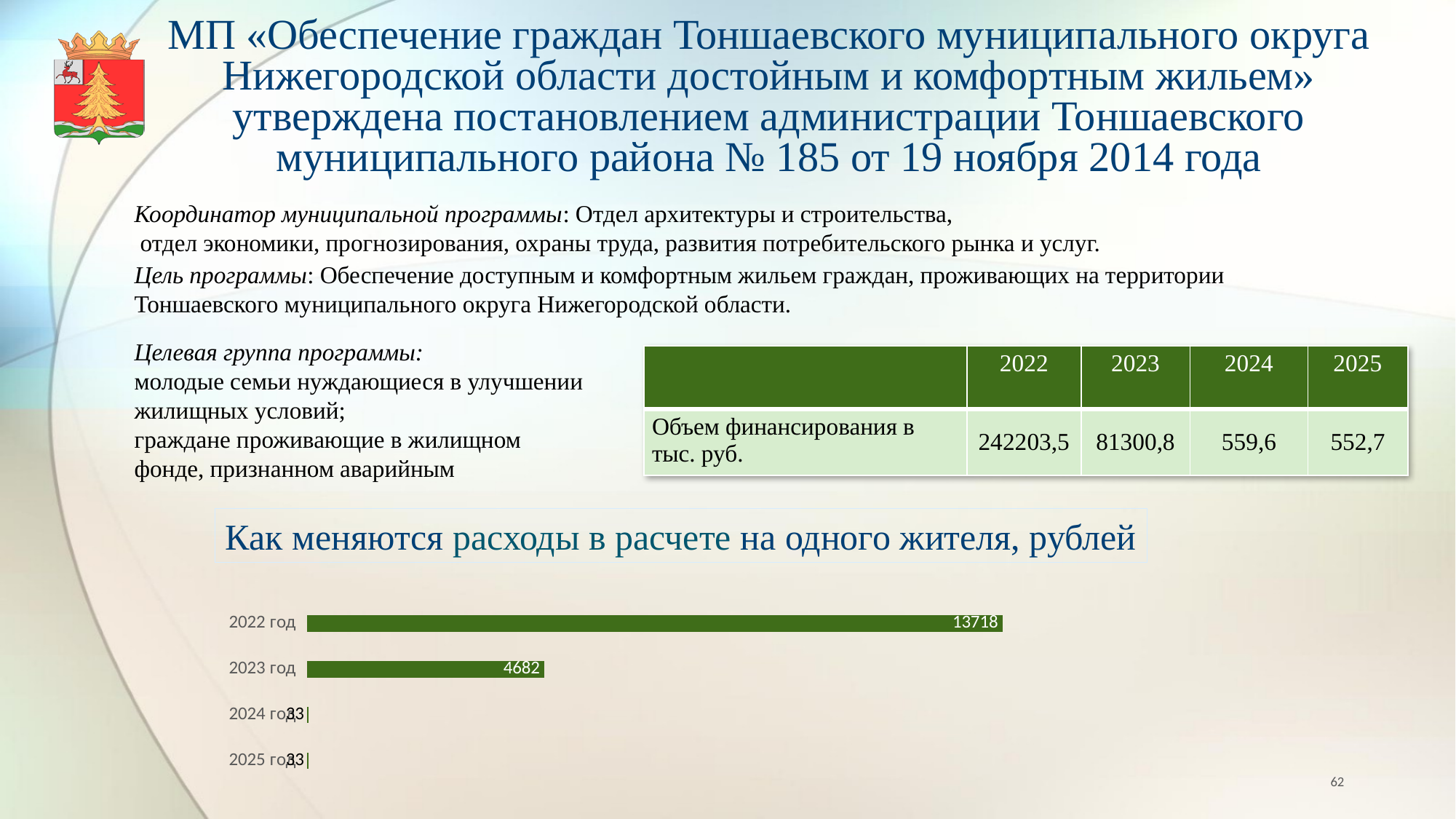
How many years (categories) are shown in the chart 'Как меняются расходы в расчете на одного жителя, рублей'? 4 What is the value for 2023 год in the chart 'Как меняются расходы в расчете на одного жителя, рублей'? 4682 In the chart 'Как меняются расходы в расчете на одного жителя, рублей', which is larger: the value for 2022 год or for 2023 год? 2022 год Which year has the highest value in the chart 'Как меняются расходы в расчете на одного жителя, рублей'? 2022 год What is the difference between the values for 2022 год and 2023 год in the chart 'Как меняются расходы в расчете на одного жителя, рублей'? 9036 What colour are the bars in the chart 'Как меняются расходы в расчете на одного жителя, рублей'? green Do the values in the chart 'Как меняются расходы в расчете на одного жителя, рублей' rise or fall from 2022 год to 2025 год? fall What is the value for 2022 год in the chart 'Как меняются расходы в расчете на одного жителя, рублей'? 13718 What kind of chart is 'Как меняются расходы в расчете на одного жителя, рублей'? bar chart In the chart 'Как меняются расходы в расчете на одного жителя, рублей', which is larger: the value for 2023 год or for 2024 год? 2023 год What is the title of the bar chart at the bottom of the slide? Как меняются расходы в расчете на одного жителя, рублей